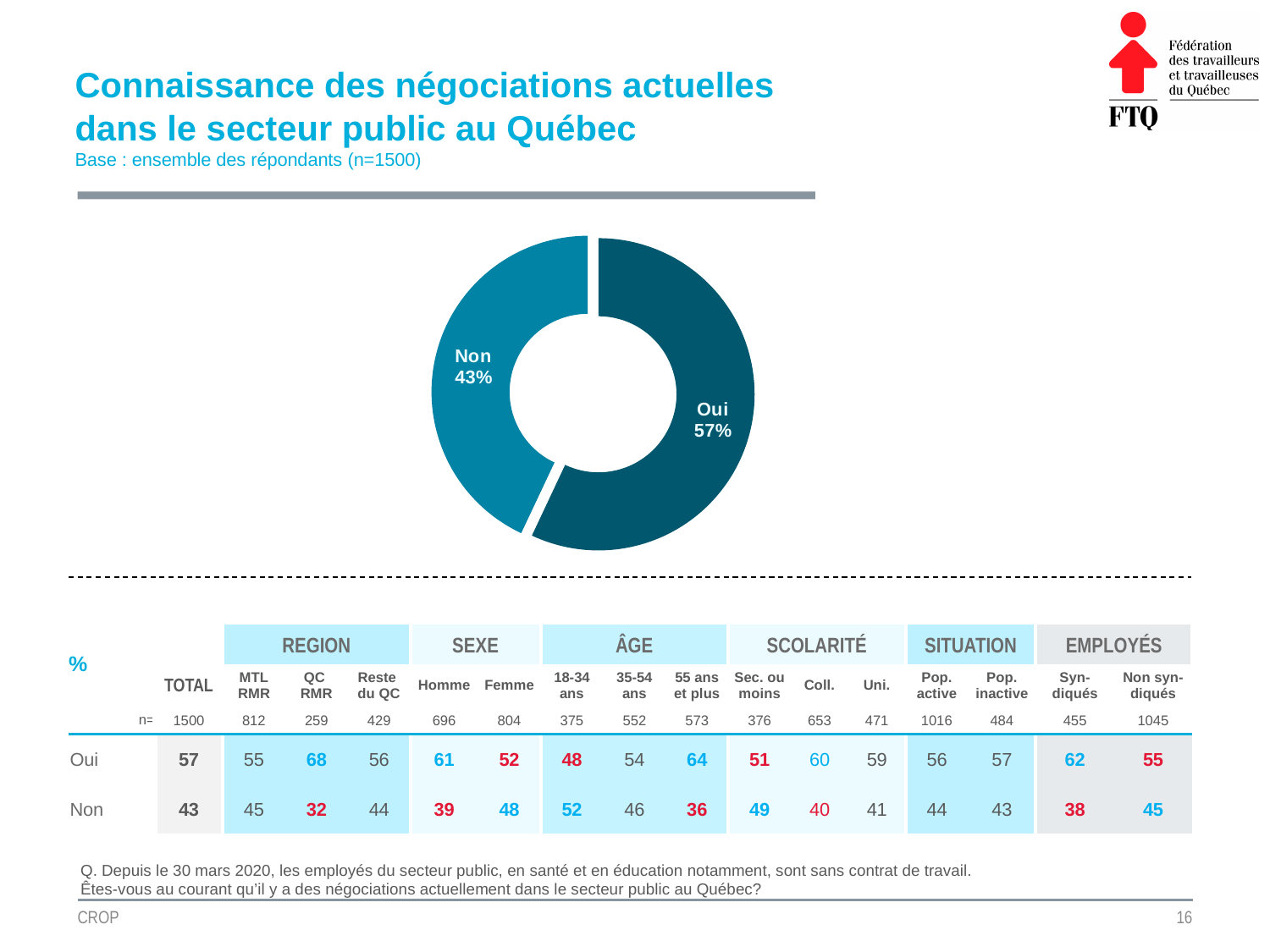
What kind of chart is shown on the slide? Doughnut chart What share of the pie chart does the "Non" slice represent? 43% What percentage of respondents answered "Non" in the pie chart? 43% Which slice of the pie chart is the largest? Oui By how many percentage points does "Oui" exceed "Non" in the pie chart? 14 How many slices does the pie chart have? 2 What is the base (n) stated for the pie chart? n=1500 What percentage of respondents answered "Oui" in the pie chart? 57% Which slice of the pie chart is the smallest? Non Which is larger in the pie chart, "Oui" or "Non"? Oui What is the title of the slide containing the pie chart? Connaissance des négociations actuelles dans le secteur public au Québec